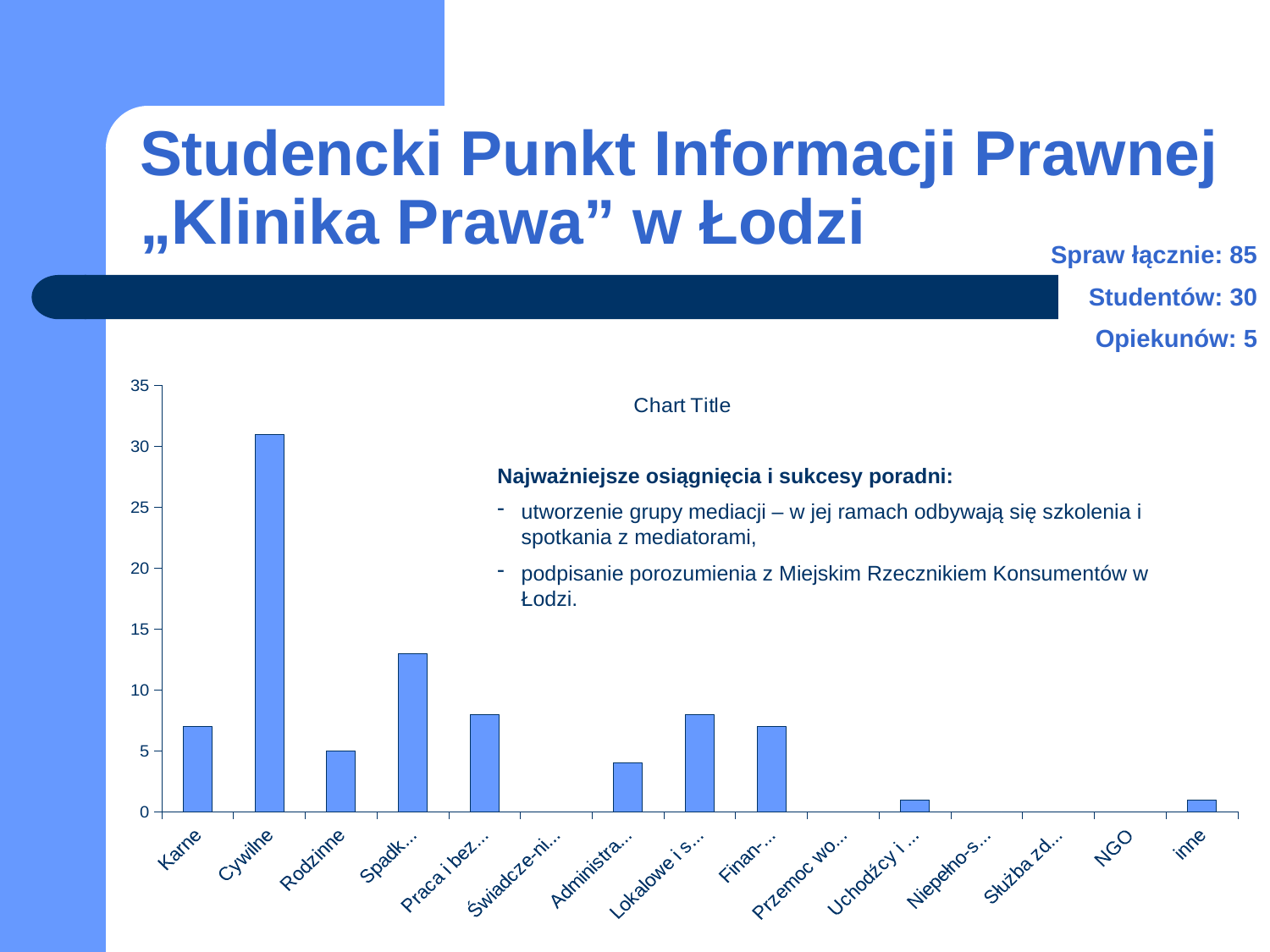
Which is larger, the value for Spadk... or the value for Karne? Spadk... How many categories are shown on the x axis of the chart? 15 Is the value for Cywilne greater or less than 30? greater What is the title shown on the chart? Chart Title Is the value for Karne greater or less than 5? greater What is the value for Rodzinne? 5 Is the value for Administra... greater or less than 5? less Which category has the highest bar in the chart? Cywilne What kind of chart is shown on the slide? bar chart Which is larger, the value for Karne or the value for Administra...? Karne